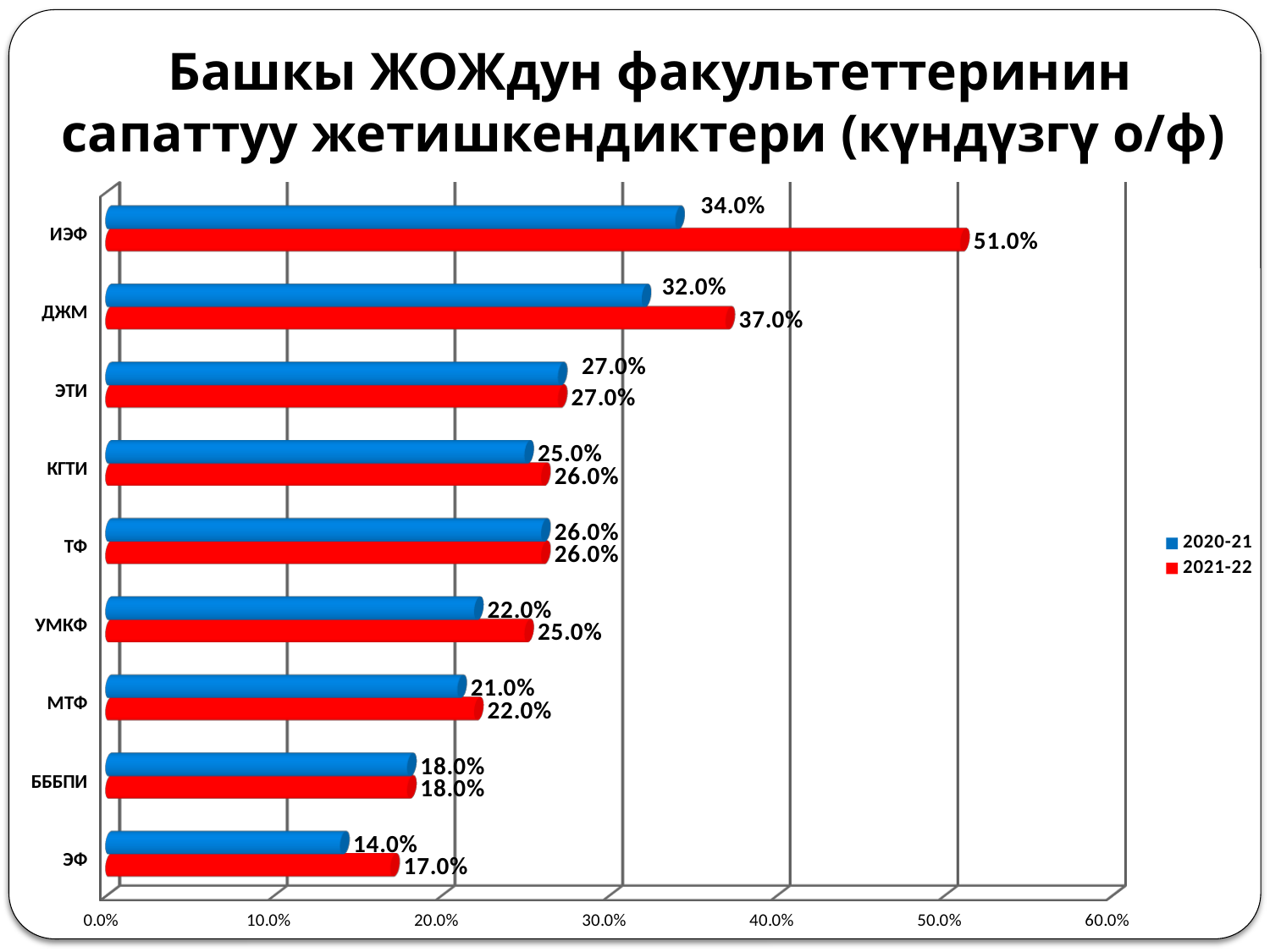
Which colour represents the 2021-22 series? red What is the 2021-22 value for УМКФ? 25.0% What is the difference between the 2021-22 and 2020-21 values for ИЭФ? 17.0% What kind of chart is shown on the slide? bar chart Which faculty has the lowest 2020-21 value? ЭФ How many series does the legend list? 2 Which is larger for ДЖМ: the 2020-21 value or the 2021-22 value? 2021-22 What is the 2020-21 value for ДЖМ? 32.0% Which faculty has the highest 2021-22 value? ИЭФ How many faculties are shown on the chart? 9 Is the 2021-22 value for ИЭФ greater or less than 40.0%? greater What is the 2021-22 value for ИЭФ? 51.0%